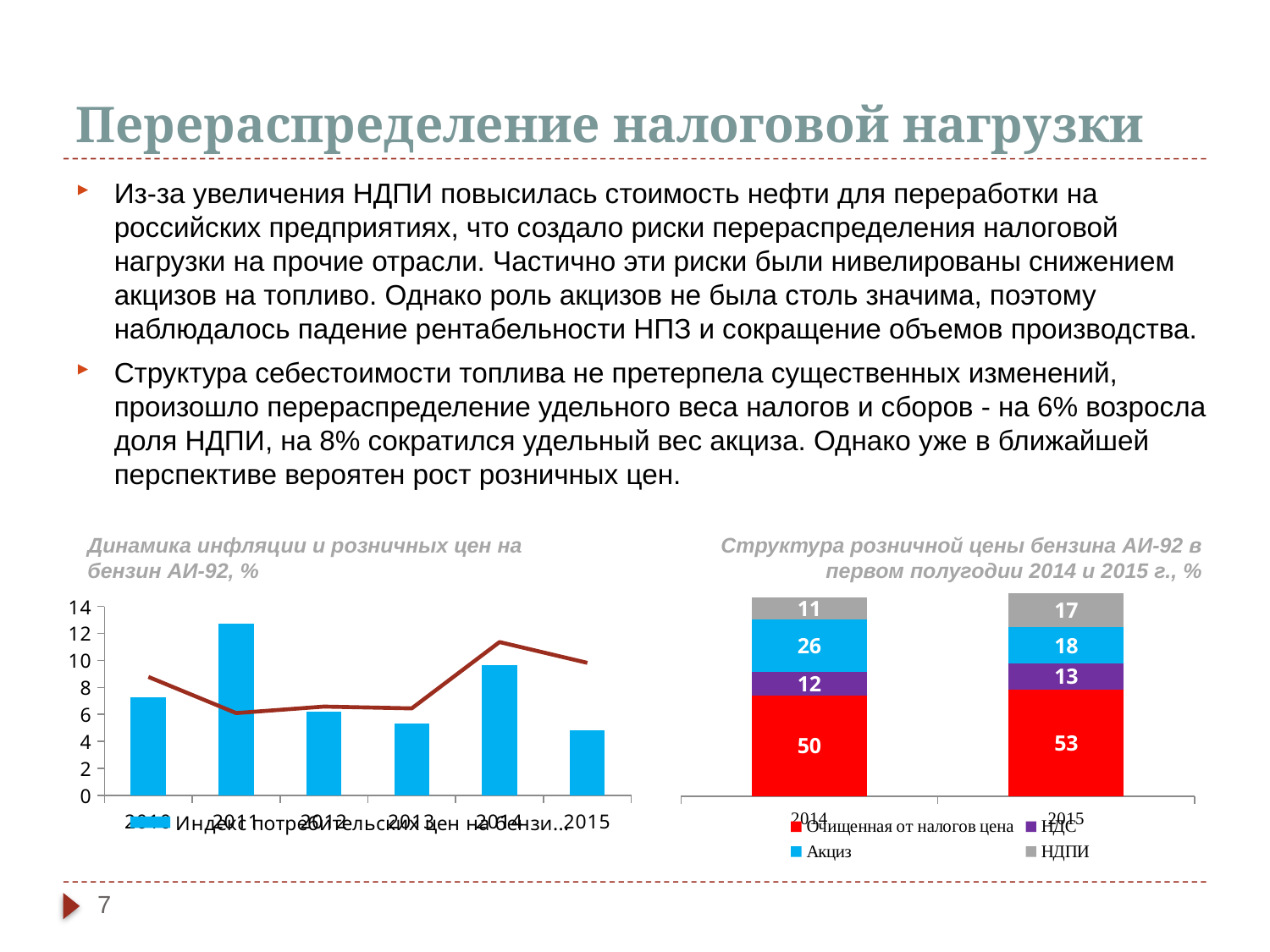
In the chart 'Структура розничной цены бензина АИ-92', by how much did the НДПИ value rise from 2014 to 2015? 6 In the chart 'Структура розничной цены бензина АИ-92', is the Очищенная от налогов цена value larger in 2014 or 2015? 2015 In the chart 'Динамика инфляции и розничных цен на бензин АИ-92', which year has the tallest bar? 2011 In the chart 'Структура розничной цены бензина АИ-92', which component is the largest in the 2015 bar? Очищенная от налогов цена In the chart 'Динамика инфляции и розничных цен на бензин АИ-92', how many years are shown on the x axis? 6 In the chart 'Структура розничной цены бензина АИ-92', what is the value of Акциз for 2014? 26 In the chart 'Структура розничной цены бензина АИ-92', what is the total of the 2014 stacked bar? 99 In the chart 'Динамика инфляции и розничных цен на бензин АИ-92', is the bar for 2011 greater or less than 12? greater In the chart 'Структура розничной цены бензина АИ-92', what is the value of НДПИ for 2015? 17 In the chart 'Структура розничной цены бензина АИ-92', by how much did the Акциз value fall from 2014 to 2015? 8 In the chart 'Структура розничной цены бензина АИ-92', how many series does the legend list? 4 In the chart 'Структура розничной цены бензина АИ-92', what kind of chart is it? stacked bar chart